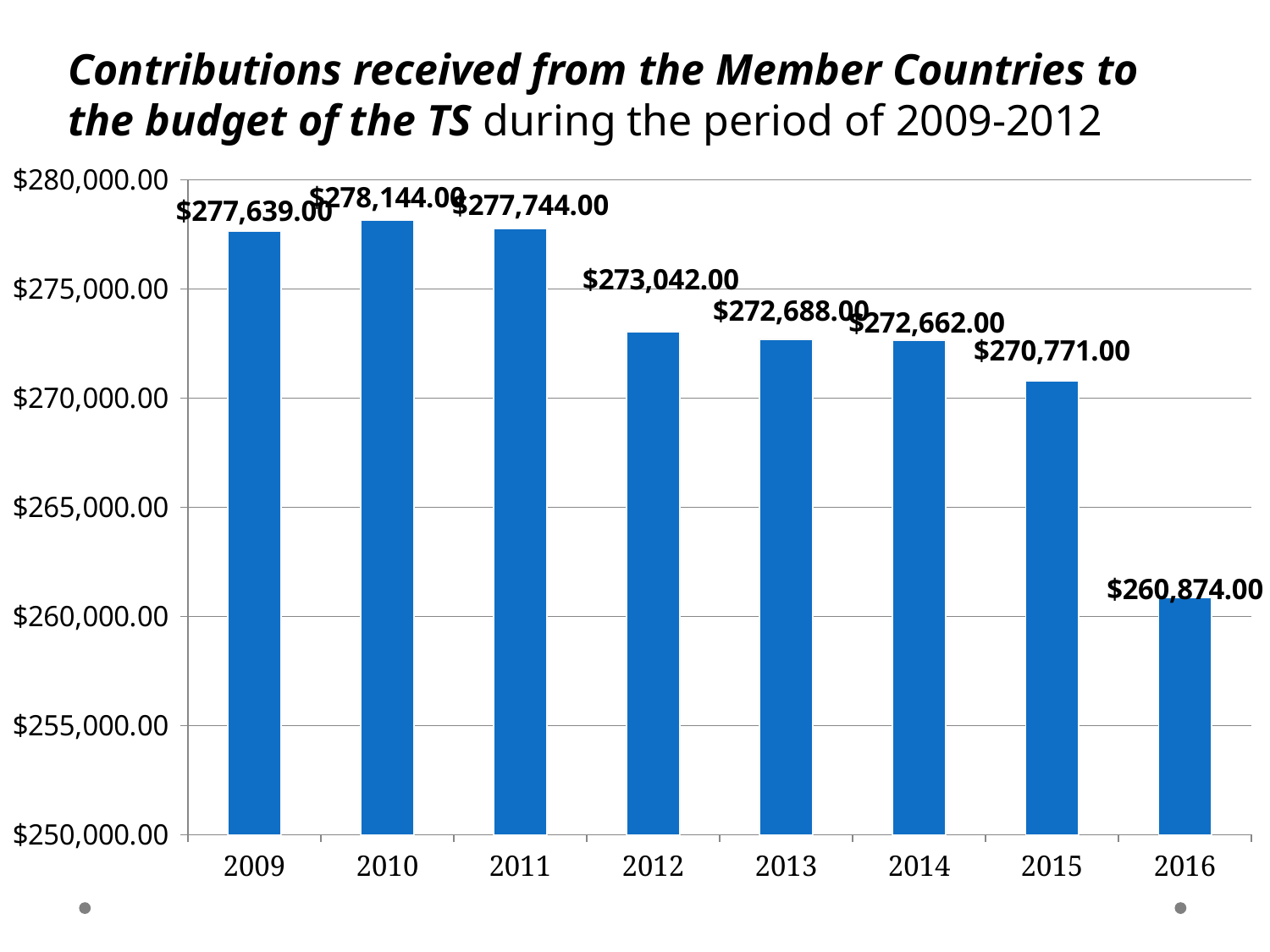
Do the contributions generally rise or fall from 2010 to 2016? Fall Is the value for 2016 greater or less than $265,000.00? less What was the contribution received in 2015? $270,771.00 What type of chart is shown on the slide? Bar chart What was the contribution received in 2009? $277,639.00 Which year had a larger contribution, 2012 or 2015? 2012 What is the difference between the contributions in 2009 and 2016? $16,765.00 What was the contribution received in 2016? $260,874.00 What was the contribution received in 2012? $273,042.00 How many years are plotted on the chart? 8 Which year had the highest contribution? 2010 Which year had the lowest contribution? 2016